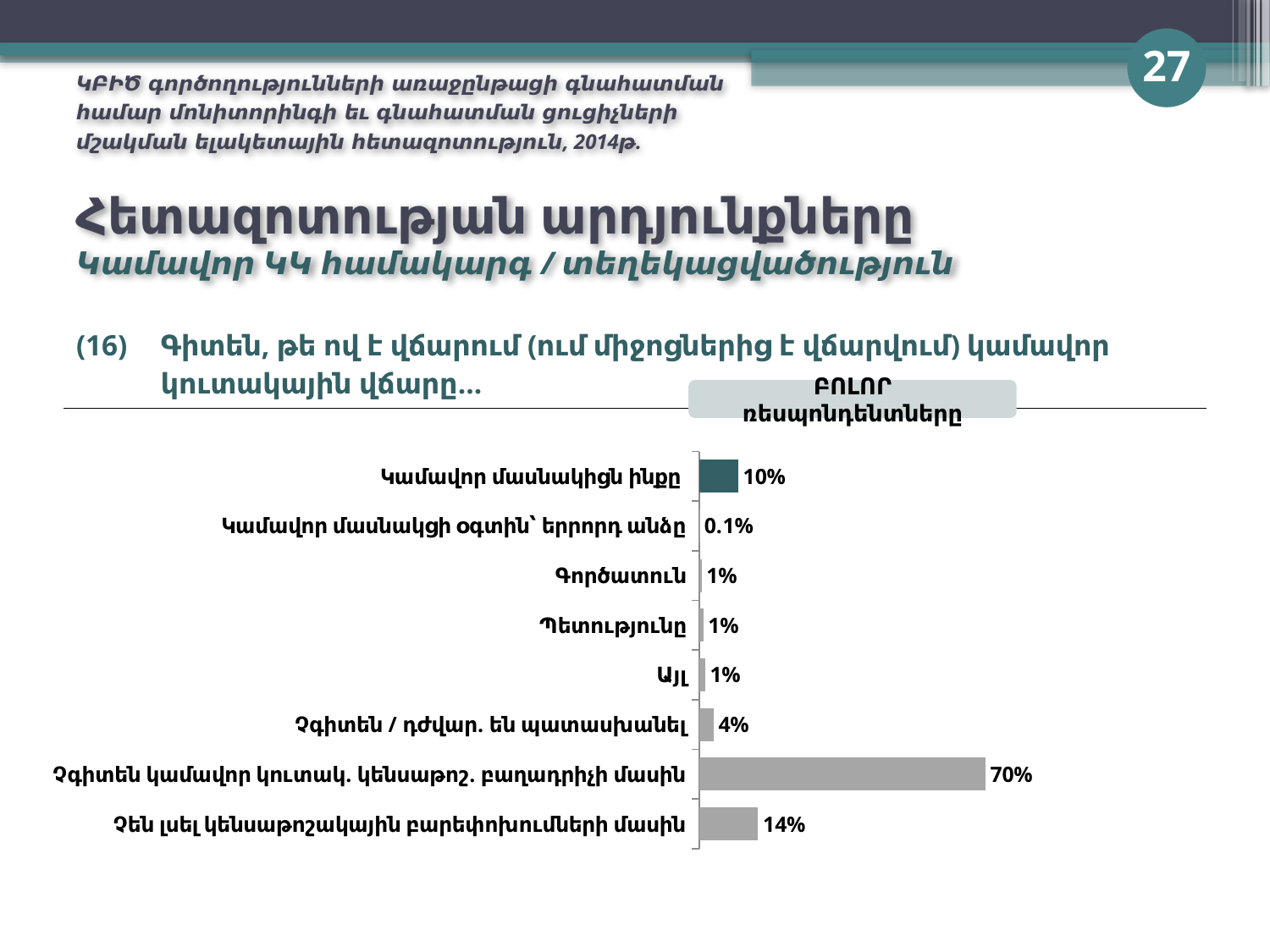
What is the value for "Չգիտեն / դժվար. են պատասխանել"? 4% Which category has the lowest value? Կամավոր մասնակցի օգտին՝ երրորդ անձը What is the difference between the values for "Չգիտեն կամավոր կուտակ. կենսաթոշ. բաղադրիչի մասին" and "Չեն լսել կենսաթոշակային բարեփոխումների մասին"? 56% Which category has the highest value? Չգիտեն կամավոր կուտակ. կենսաթոշ. բաղադրիչի մասին What is the value for "Կամավոր մասնակիցն ինքը"? 10% What is the value for "Գործատուն"? 1% What type of chart is shown on the slide? bar chart What is the value for "Կամավոր մասնակցի օգտին՝ երրորդ անձը"? 0.1% What group of respondents does the column header above the chart refer to? ԲՈԼՈՐ ռեսպոնդենտները Which is larger: the value for "Կամավոր մասնակիցն ինքը" or the value for "Չգիտեն / դժվար. են պատասխանել"? Կամավոր մասնակիցն ինքը How many categories are plotted in the bar chart? 8 What is the value for "Չեն լսել կենսաթոշակային բարեփոխումների մասին"? 14%